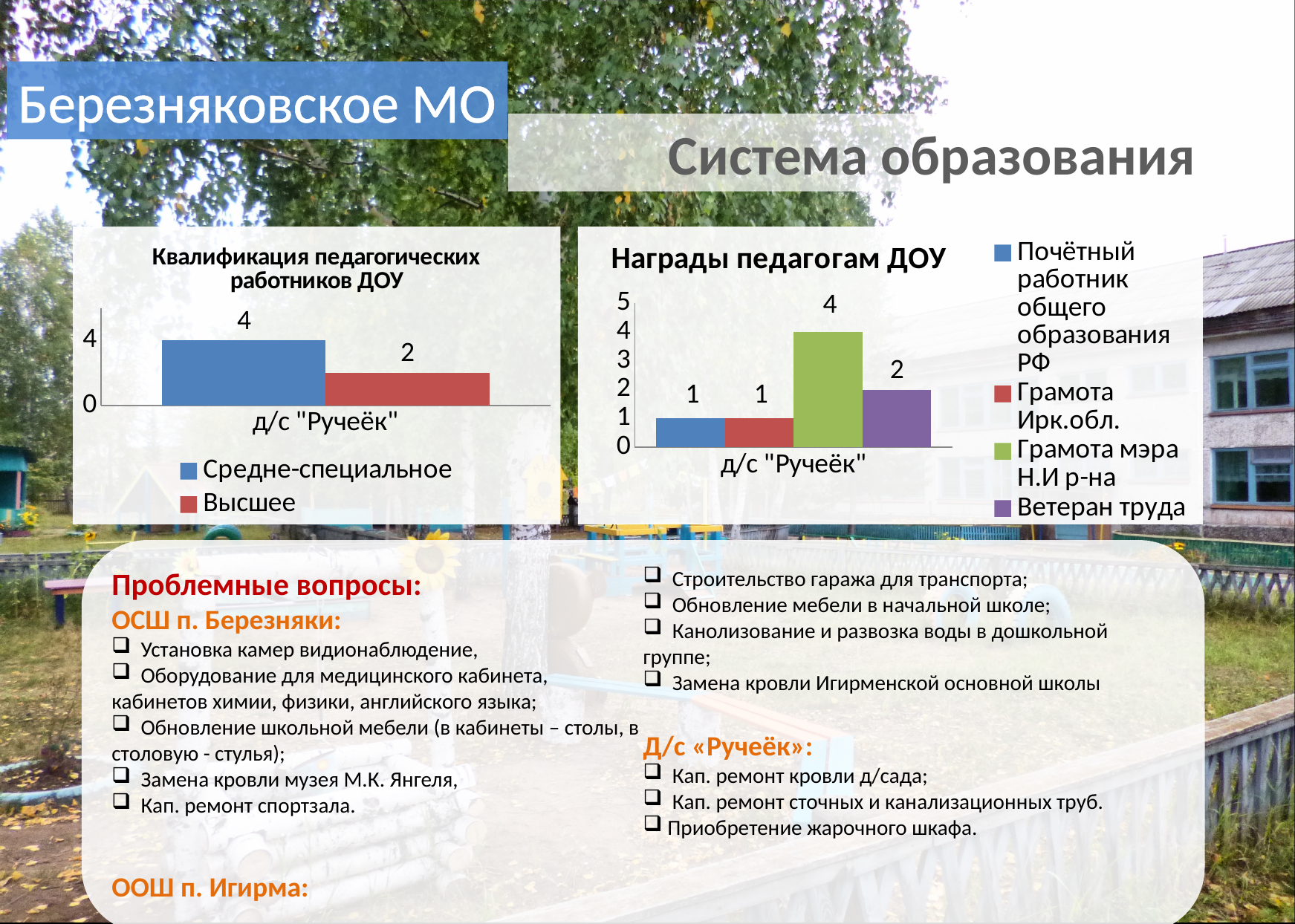
In the chart "Награды педагогам ДОУ", what is the value for Ветеран труда? 2 In the chart "Награды педагогам ДОУ", what is the value for Грамота Ирк.обл.? 1 In the chart "Награды педагогам ДОУ", how many series does the legend list? 4 In the chart "Квалификация педагогических работников ДОУ", which series is larger, Средне-специальное or Высшее? Средне-специальное In the chart "Квалификация педагогических работников ДОУ", what is the value for Средне-специальное? 4 In the chart "Награды педагогам ДОУ", what is the value for Грамота мэра Н.И р-на? 4 In the chart "Награды педагогам ДОУ", which series has the highest value? Грамота мэра Н.И р-на In the chart "Награды педагогам ДОУ", what is the difference between Грамота мэра Н.И р-на and Ветеран труда? 2 In the chart "Квалификация педагогических работников ДОУ", what is the difference between Средне-специальное and Высшее? 2 In the chart "Квалификация педагогических работников ДОУ", what is the value for Высшее? 2 In the chart "Квалификация педагогических работников ДОУ", how many series does the legend list? 2 What kind of chart is "Награды педагогам ДОУ"? bar chart